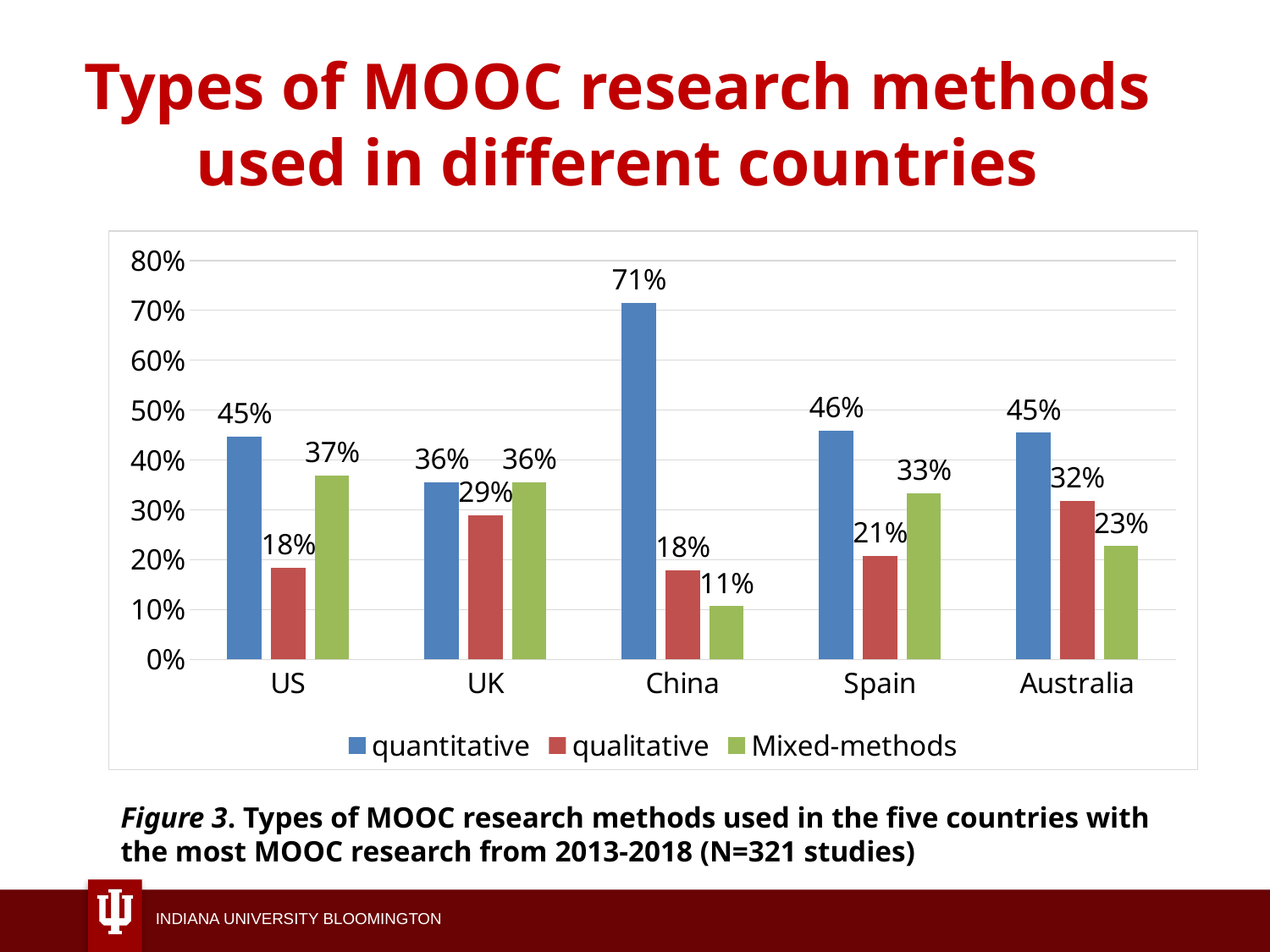
What is the qualitative value for Australia? 32% Is the quantitative value for Spain greater or less than 40%? greater Which country has the highest quantitative value? China What is the quantitative value for China? 71% How many countries are shown on the x axis? 5 How many series does the legend list? 3 Which colour represents the qualitative series? red What kind of chart is shown? bar chart What is the difference between the quantitative and qualitative values for China? 53% What is the Mixed-methods value for Spain? 33% Which is larger for the UK: the qualitative value or the Mixed-methods value? Mixed-methods Which country has the lowest Mixed-methods value? China